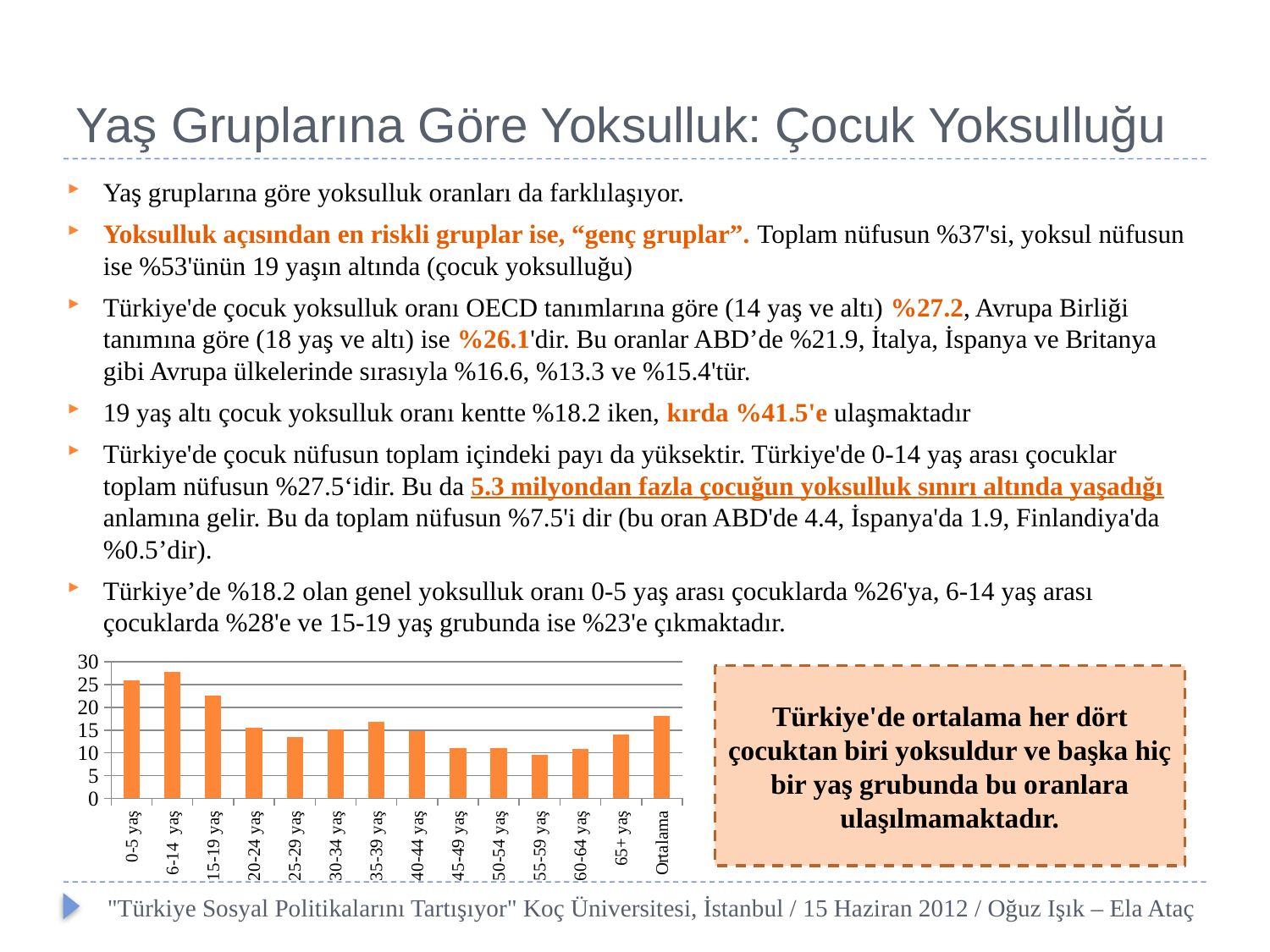
Which is larger, the value for 0-5 yaş or the value for 15-19 yaş? 0-5 yaş Is the value for 6-14 yaş greater or less than 25? greater Which age group has the lowest bar in the chart? 55-59 yaş Which is larger, the value for 35-39 yaş or the value for 45-49 yaş? 35-39 yaş Is the value for 35-39 yaş greater or less than 15? greater Is the value for 25-29 yaş greater or less than 15? less What colour are the bars in the chart? orange What kind of chart is shown on the slide? bar chart How many categories are shown on the x axis of the chart? 14 Which age group has the highest bar in the chart? 6-14 yaş